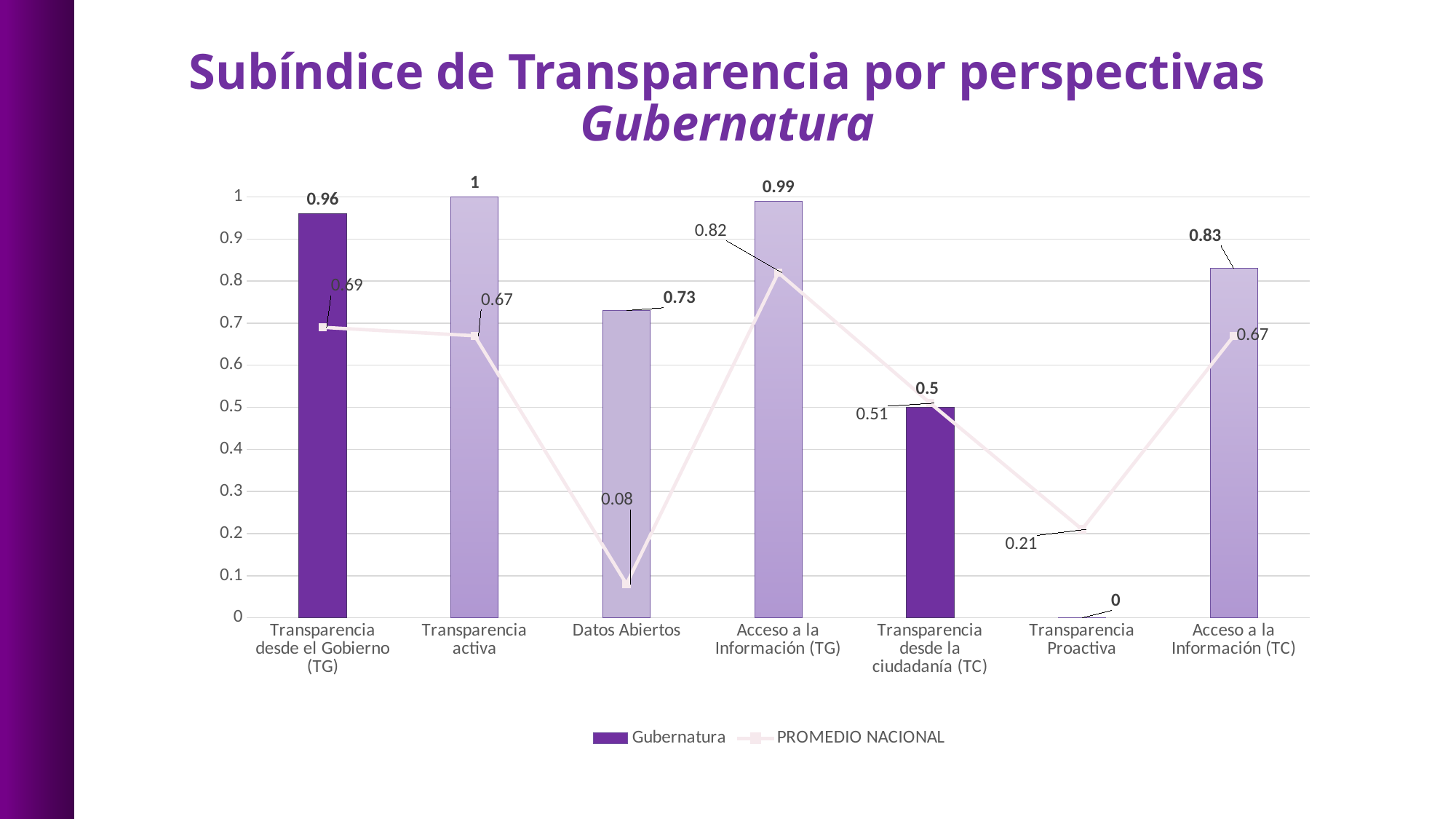
For Transparencia desde la ciudadanía (TC), which is larger: the Gubernatura value or the PROMEDIO NACIONAL value? PROMEDIO NACIONAL What is the difference between the Gubernatura value and the PROMEDIO NACIONAL value for Datos Abiertos? 0.65 What is the title of the chart on the slide? Subíndice de Transparencia por perspectivas Gubernatura What is the PROMEDIO NACIONAL value for Transparencia Proactiva? 0.21 How many categories are shown on the x axis? 7 Which category has the lowest Gubernatura value? Transparencia Proactiva What kind of chart is shown on the slide? Combined bar and line chart Which category has the highest PROMEDIO NACIONAL value? Acceso a la Información (TG) What is the PROMEDIO NACIONAL value for Datos Abiertos? 0.08 How many series does the legend list? 2 What is the Gubernatura value for Transparencia activa? 1 What is the Gubernatura value for Acceso a la Información (TC)? 0.83